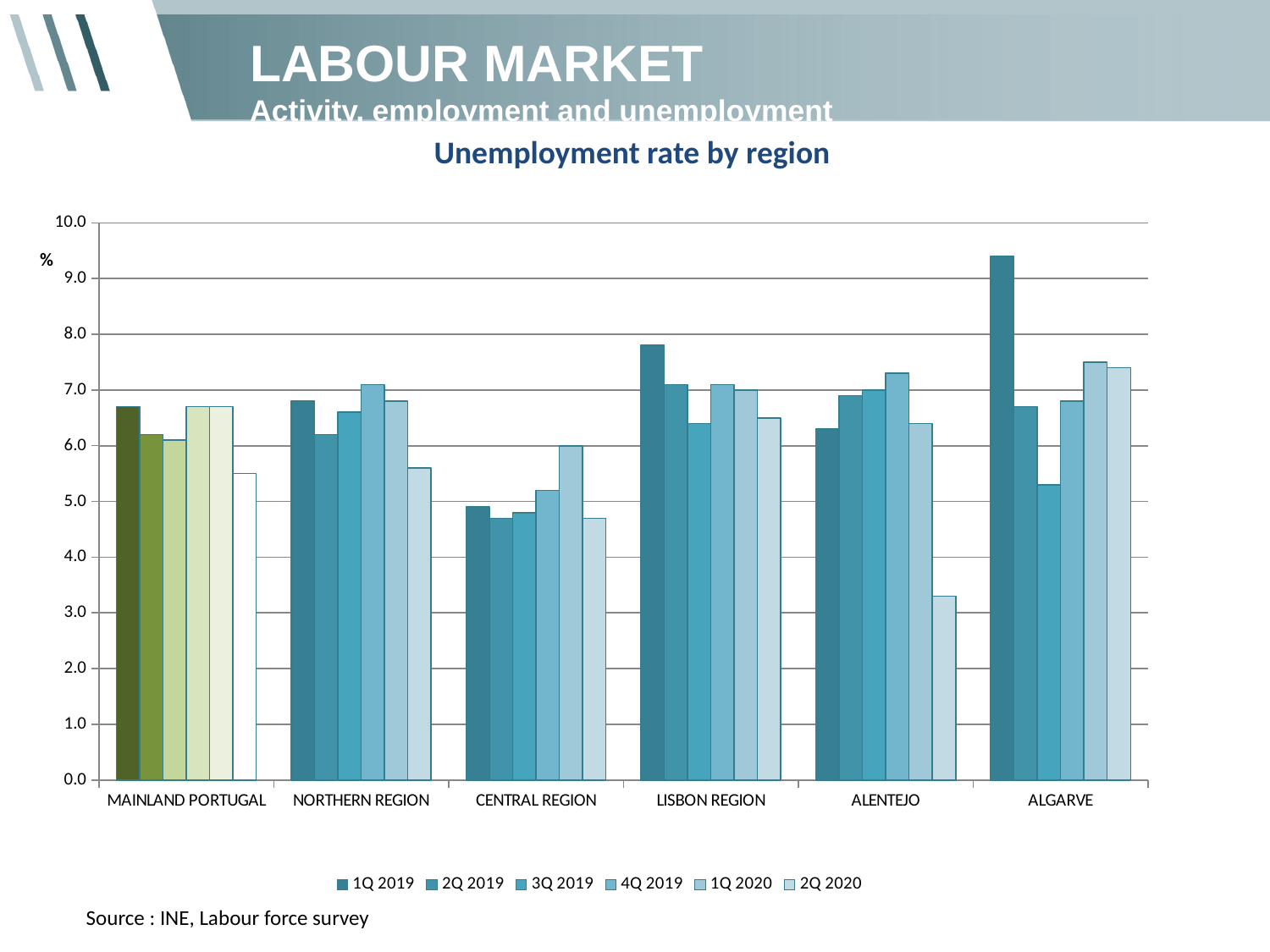
Which region has the highest 1Q 2019 unemployment rate? ALGARVE For MAINLAND PORTUGAL, which is larger, the 1Q 2020 value or the 2Q 2020 value? 1Q 2020 Which is larger, the 1Q 2019 value for LISBON REGION or for NORTHERN REGION? LISBON REGION What is the title of the chart? Unemployment rate by region How many series does the legend list? 6 Is the 2Q 2019 value for CENTRAL REGION greater or less than 5.0? less Is the 2Q 2020 value for ALENTEJO greater or less than 4.0? less Is the 1Q 2019 value for ALGARVE greater or less than 9.0? greater How many regions are shown on the x axis? 6 What kind of chart is shown on the slide? bar chart Which region has the lowest 2Q 2020 unemployment rate? ALENTEJO